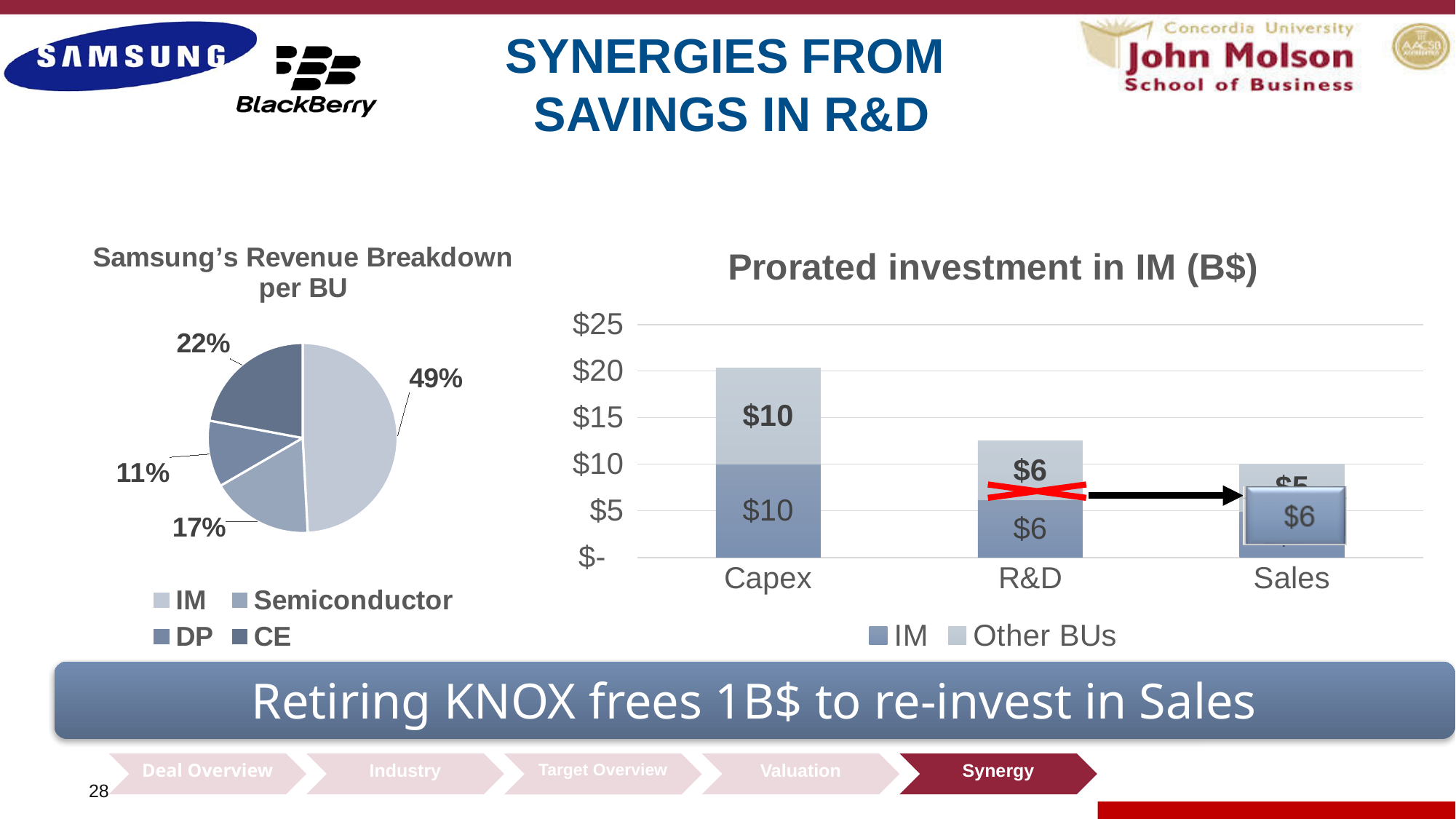
In the pie chart 'Samsung's Revenue Breakdown per BU', which business unit has the largest share? IM In the chart 'Prorated investment in IM (B$)', what is the Other BUs value for Capex? $10 In the chart 'Prorated investment in IM (B$)', how many series does the legend list? 2 In the pie chart 'Samsung's Revenue Breakdown per BU', what percentage is shown for CE? 22% In the pie chart 'Samsung's Revenue Breakdown per BU', how many slices are there? 4 In the pie chart 'Samsung's Revenue Breakdown per BU', what share does IM hold? 49% In the chart 'Prorated investment in IM (B$)', what is the total of the Capex stacked bar? $20 In the chart 'Prorated investment in IM (B$)', what is the IM value for Capex? $10 In the pie chart 'Samsung's Revenue Breakdown per BU', what is the difference between the Semiconductor share and the DP share? 6% What kind of chart is 'Prorated investment in IM (B$)'? Stacked bar chart In the pie chart 'Samsung's Revenue Breakdown per BU', which business unit has the smallest share? DP In the chart 'Prorated investment in IM (B$)', which category has the tallest stacked bar? Capex